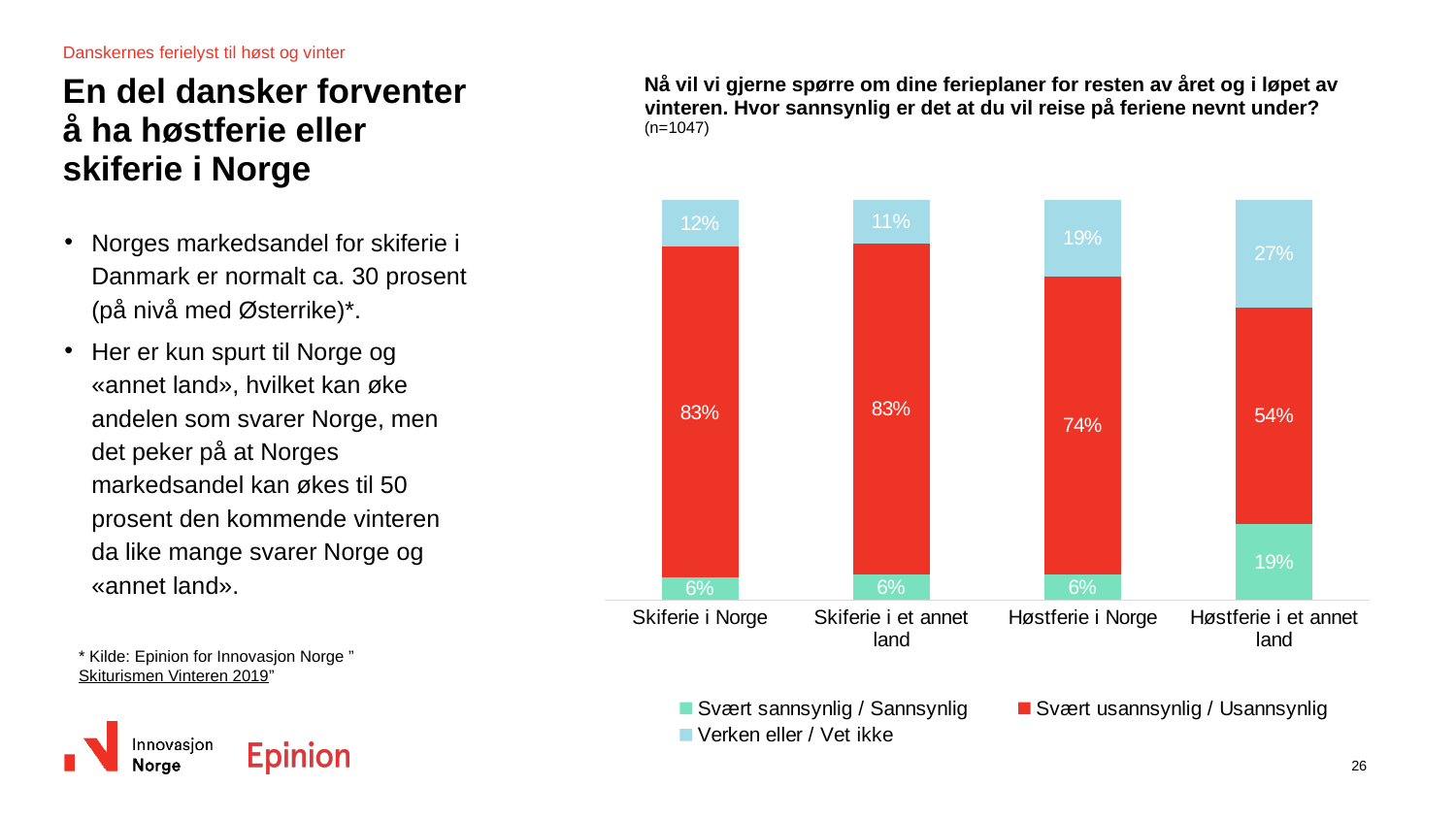
What is the difference between the 'Svært usannsynlig / Usannsynlig' values for 'Skiferie i Norge' and 'Høstferie i et annet land'? 29% What is the total of the stacked bar for 'Høstferie i Norge'? 99% Which category has the highest value for 'Verken eller / Vet ikke'? Høstferie i et annet land What is the value for 'Svært sannsynlig / Sannsynlig' for 'Høstferie i et annet land'? 19% Which is larger: the 'Svært sannsynlig / Sannsynlig' value for 'Høstferie i et annet land' or for 'Høstferie i Norge'? Høstferie i et annet land How many categories are shown on the x axis of the chart? 4 What is the value for 'Svært usannsynlig / Usannsynlig' for 'Høstferie i Norge'? 74% What is the value for 'Verken eller / Vet ikke' for 'Skiferie i et annet land'? 11% Which category has the lowest value for 'Svært usannsynlig / Usannsynlig'? Høstferie i et annet land How many series does the chart legend list? 3 What kind of chart is shown on the slide? Stacked bar chart What colour represents the 'Svært usannsynlig / Usannsynlig' series in the chart? Red